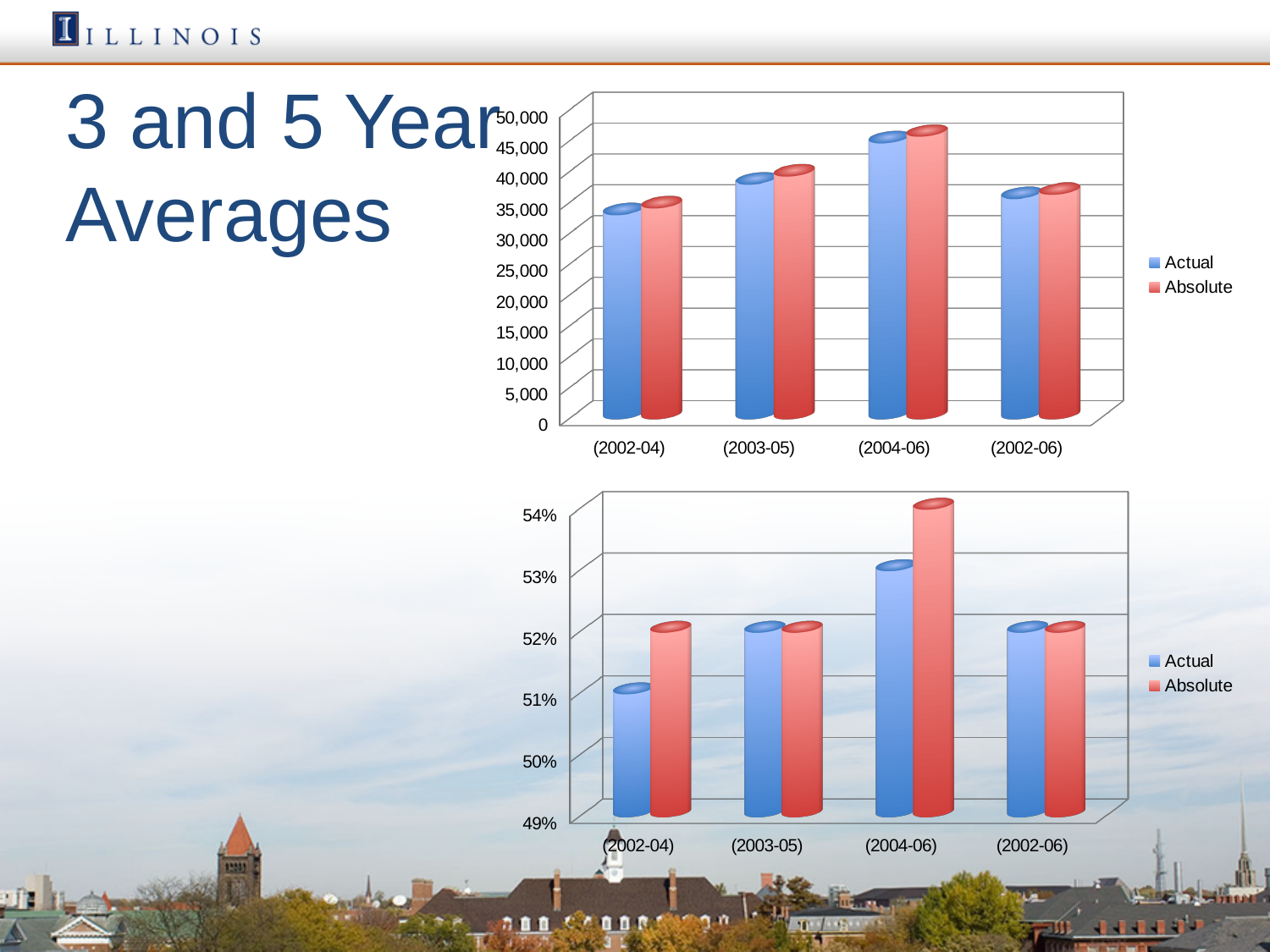
How many series does the legend of the top chart list? 2 In the bottom chart, which category has the lowest Actual value? (2002-04) In the bottom chart, is the Absolute value for (2004-06) greater or less than 53%? greater In the top chart, which category has the lowest Actual value? (2002-04) In the bottom chart, for (2002-04), which is larger: the Actual value or the Absolute value? Absolute How many categories are shown on the x axis of the top chart? 4 In the top chart, is the Actual value for (2004-06) greater or less than 40,000? greater In the top chart, is the Actual value for (2002-04) greater or less than 30,000? greater What kind of chart is the top chart on the slide? bar chart In the top chart, which category has the highest Actual value? (2004-06) In the bottom chart, which category has the highest Absolute value? (2004-06) What are the two legend entries in the bottom chart? Actual and Absolute